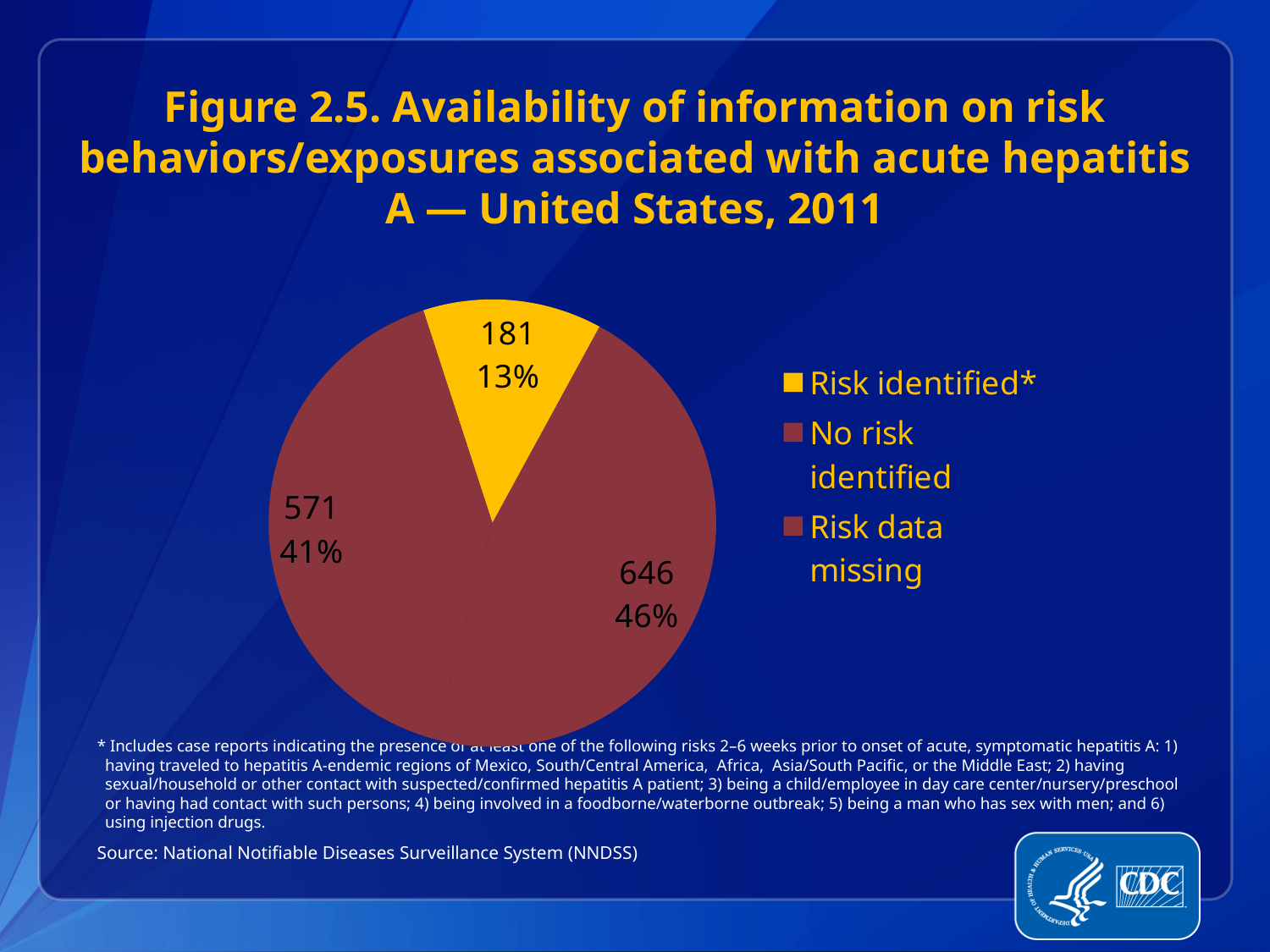
What is the value of the largest slice in the pie chart? 646 What percentage of the pie does the 'Risk identified*' slice represent? 13% What is the number of cases in the 'Risk identified*' slice? 181 What percentage is shown on the largest slice of the pie chart? 46% What is the difference between the largest slice value (646) and the smallest slice value (181)? 465 What colour is the 'Risk identified*' slice in the pie chart? yellow How many slices does the pie chart have? 3 Which legend category has the smallest slice in the pie chart? Risk identified* What is the total number of cases across all three slices of the pie chart? 1398 Is the slice labeled 571 larger or smaller than the slice labeled 646? smaller How many entries does the legend list? 3 What kind of chart is shown on the slide? pie chart